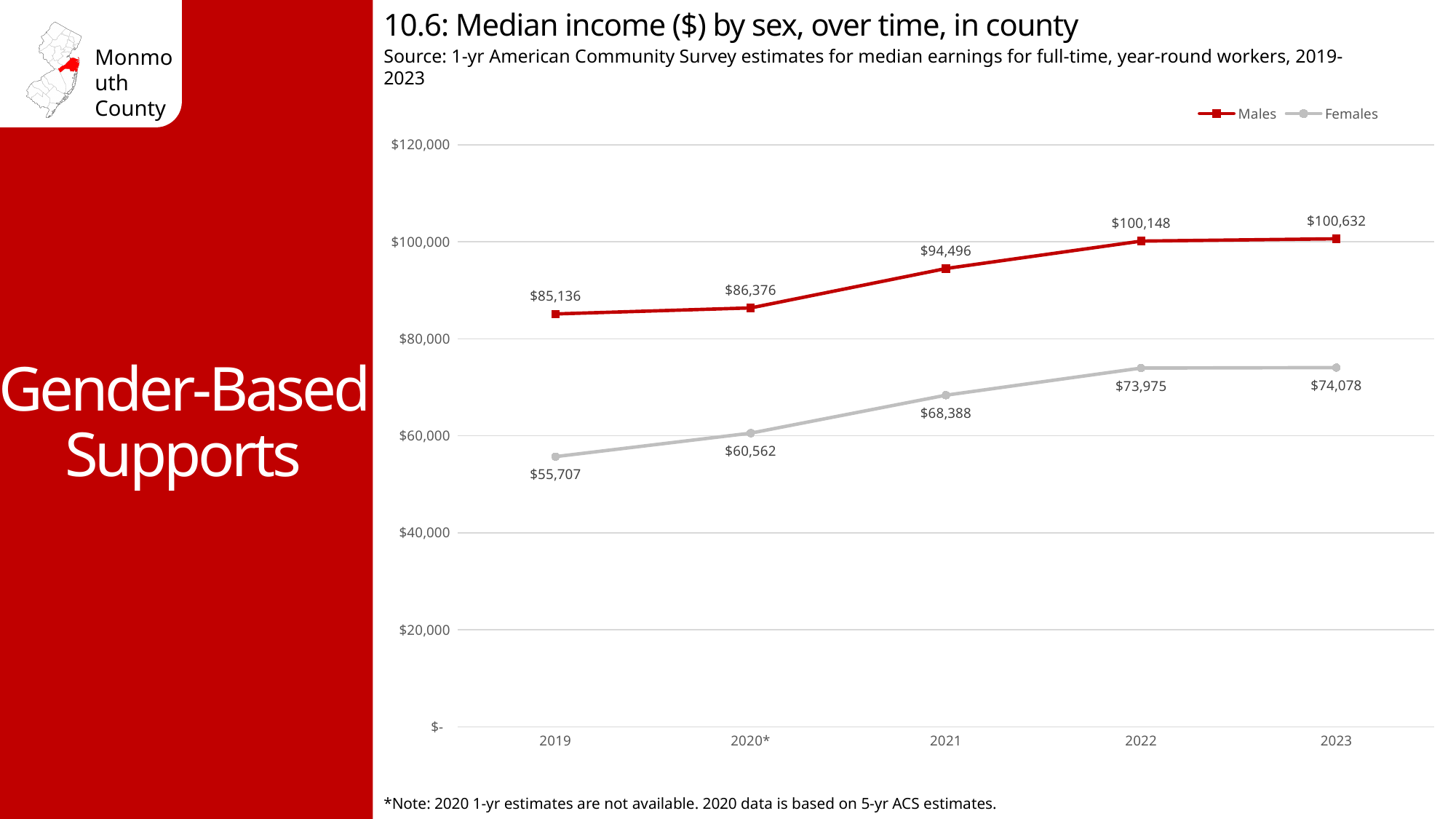
What was the median income for Males in 2021? $94,496 Is the median income for Females in 2021 greater or less than $80,000? less How many years are shown on the x axis? 5 What kind of chart is shown? line chart In which year was the median income for Females lowest? 2019 In which year was the median income for Males highest? 2023 What is the difference between the Males and Females median income in 2022? $26,173 Which series had the higher median income in 2020*, Males or Females? Males What was the median income for Females in 2023? $74,078 Does the median income for Males rise or fall from 2019 to 2023? rise What was the median income for Females in 2019? $55,707 How many series does the legend list? 2